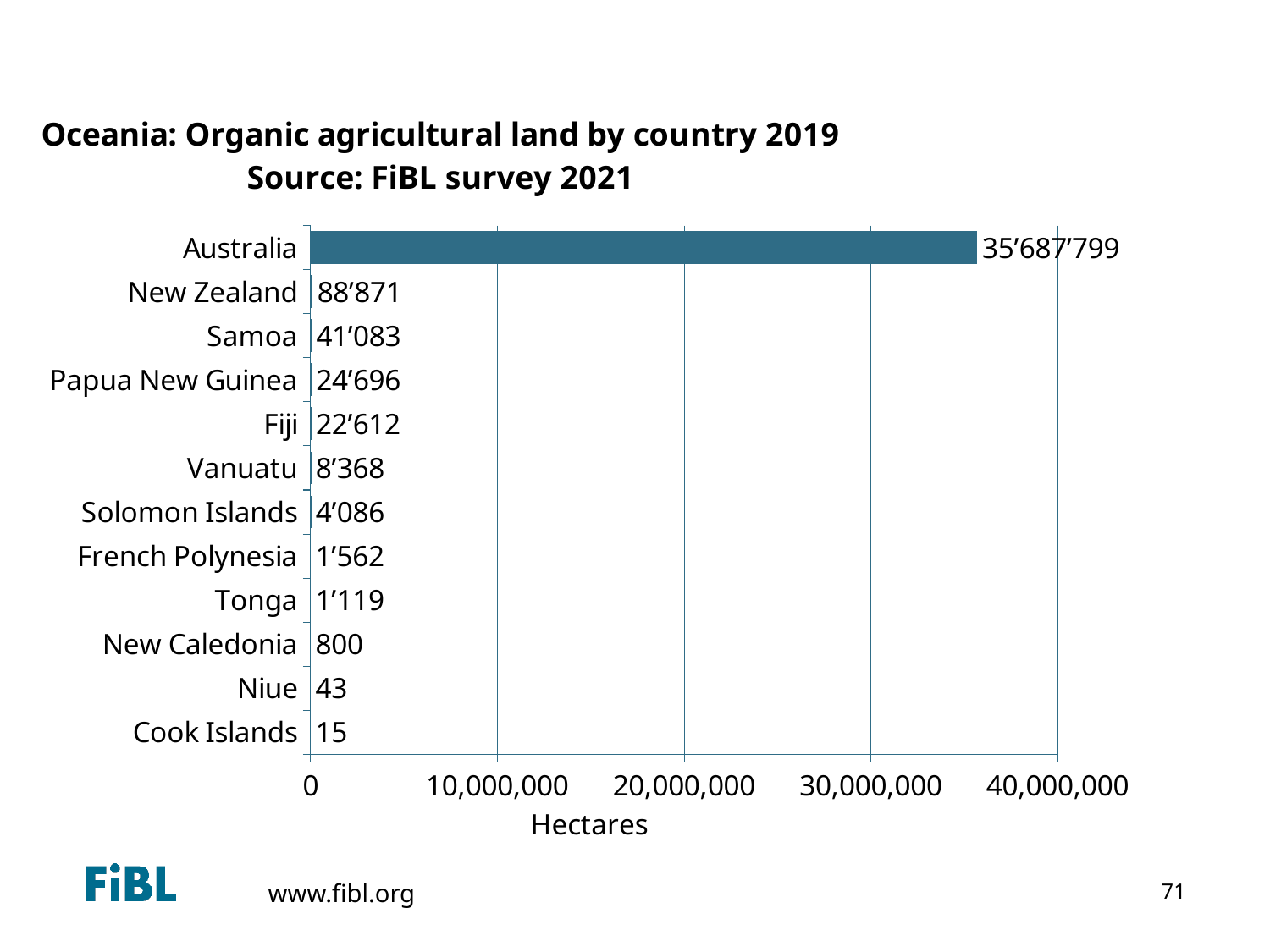
Which country has the largest organic agricultural land? Australia What kind of chart is shown on the slide? Bar chart Is the value for Australia greater or less than 30,000,000? greater What is the organic agricultural land value for Fiji? 22’612 Which country has the smallest organic agricultural land? Cook Islands What is the organic agricultural land value for New Zealand? 88’871 What is the label of the horizontal axis? Hectares Which has a larger value, Vanuatu or Solomon Islands? Vanuatu What is the organic agricultural land value for Australia? 35’687’799 How many countries are shown in the chart? 12 What is the organic agricultural land value for Niue? 43 What is the difference between the values for Samoa and Papua New Guinea? 16’387